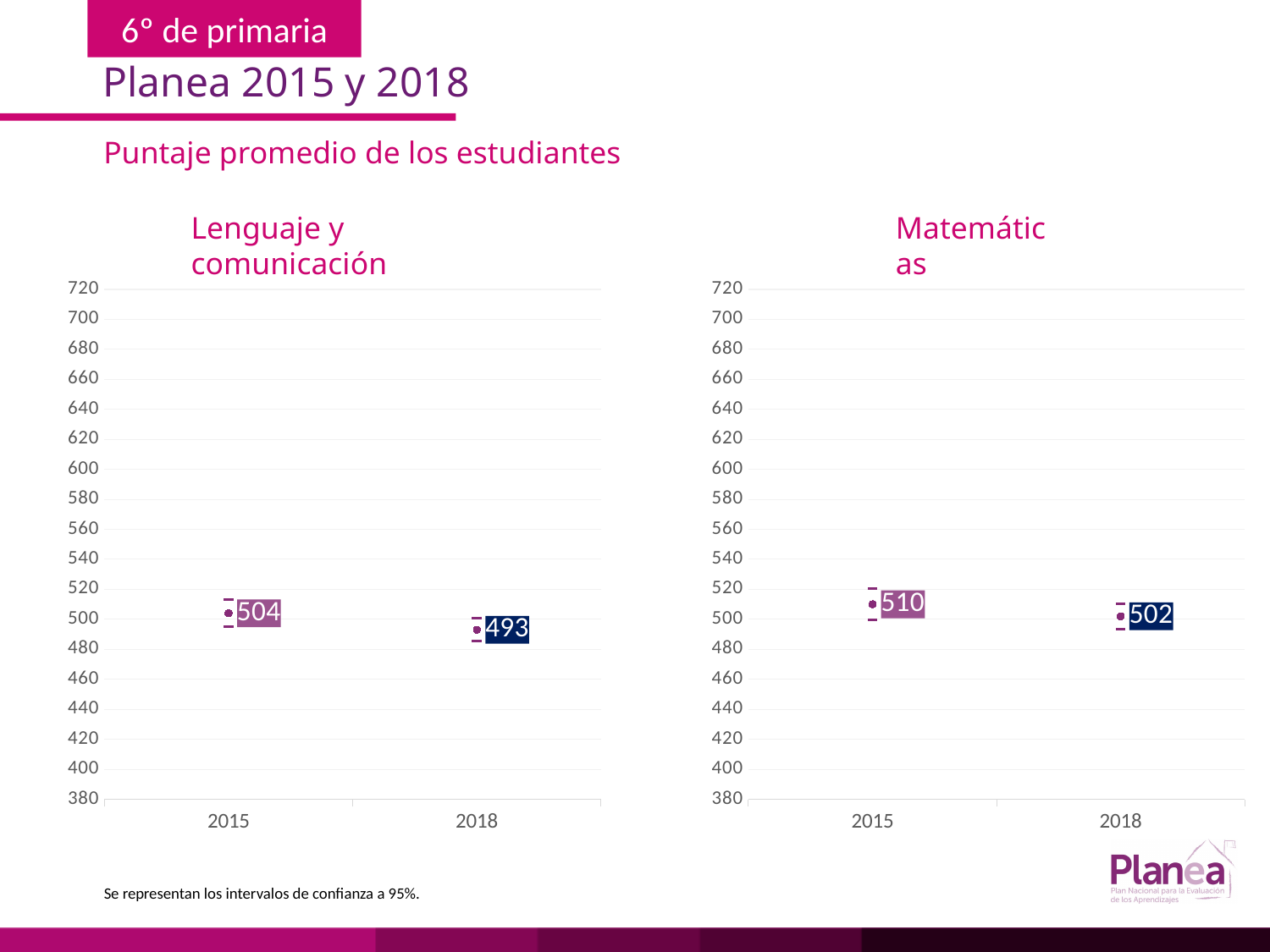
In the 'Matemáticas' chart, what is the difference between the 2015 and 2018 values? 8 In the 'Lenguaje y comunicación' chart, which year has the lower value? 2018 In the 'Matemáticas' chart, which year has the higher value? 2015 How many years are shown on the x axis of the 'Lenguaje y comunicación' chart? 2 In the 'Lenguaje y comunicación' chart, do the values rise or fall from 2015 to 2018? fall In the 'Lenguaje y comunicación' chart, what is the value for 2015? 504 In the 'Lenguaje y comunicación' chart, what is the difference between the 2015 and 2018 values? 11 In the 'Matemáticas' chart, what is the value for 2015? 510 In the 'Matemáticas' chart, what is the value for 2018? 502 In the 'Matemáticas' chart, is the value for 2018 greater or less than 500? greater What does the note at the bottom of the slide say is represented in the charts? Los intervalos de confianza a 95% In the 'Lenguaje y comunicación' chart, what is the value for 2018? 493